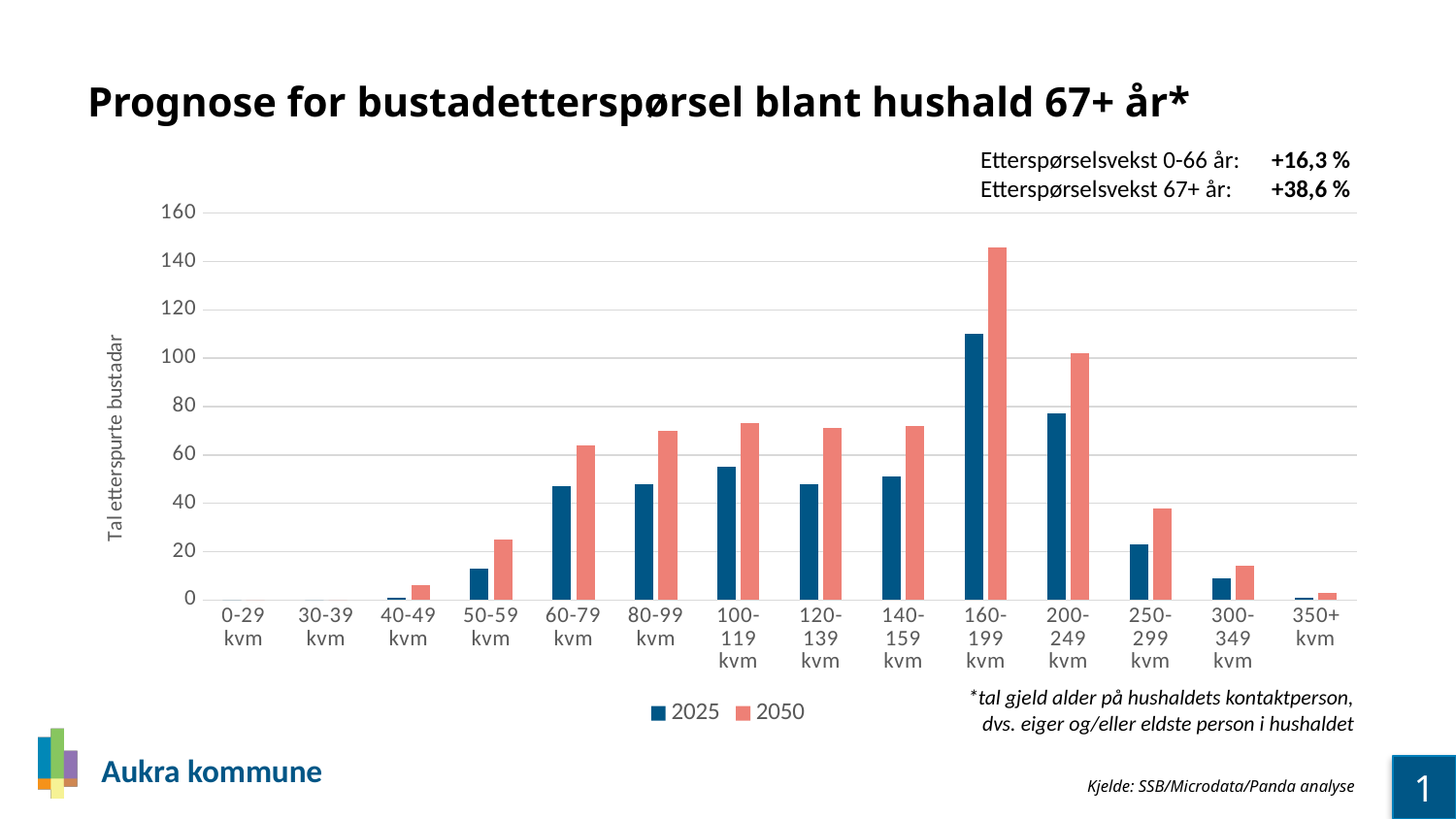
Is the 2025 value for 300-349 kvm greater or less than 20? less What kind of chart is shown on the slide? bar chart What is the title of the chart? Prognose for bustadetterspørsel blant hushald 67+ år* Which category has the highest value for 2050? 160-199 kvm Is the 2050 value for 160-199 kvm greater or less than 140? greater How many series does the legend list? 2 Which category has the highest value for 2025? 160-199 kvm Is the 2025 value for 60-79 kvm greater or less than 60? less For 160-199 kvm, which series has the larger value, 2025 or 2050? 2050 How many size categories are shown on the x axis? 14 For 2025, which category has the larger value, 160-199 kvm or 200-249 kvm? 160-199 kvm